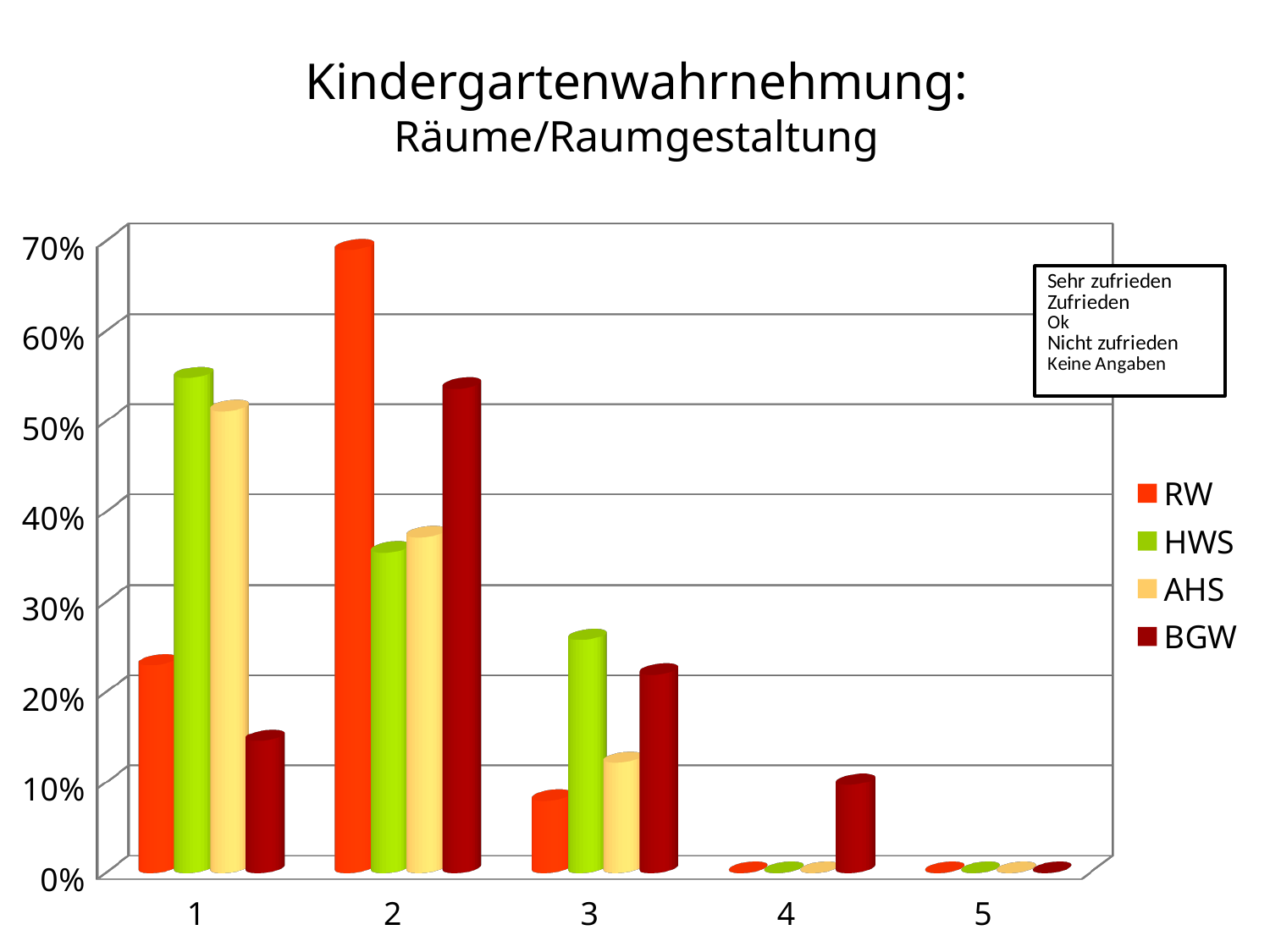
In category 3, which is larger, the HWS value or the AHS value? HWS For which category is the RW value highest? 2 Is the RW value for category 2 greater or less than 60%? greater How many series does the legend list? 4 Which series has the lowest value in category 3? RW What kind of chart is shown on the slide? bar chart Which series has the highest value in category 2? RW Is the HWS value for category 1 greater or less than 50%? greater Is the BGW value for category 4 greater or less than 20%? less In category 1, which is larger, the HWS value or the RW value? HWS How many categories are shown on the x axis? 5